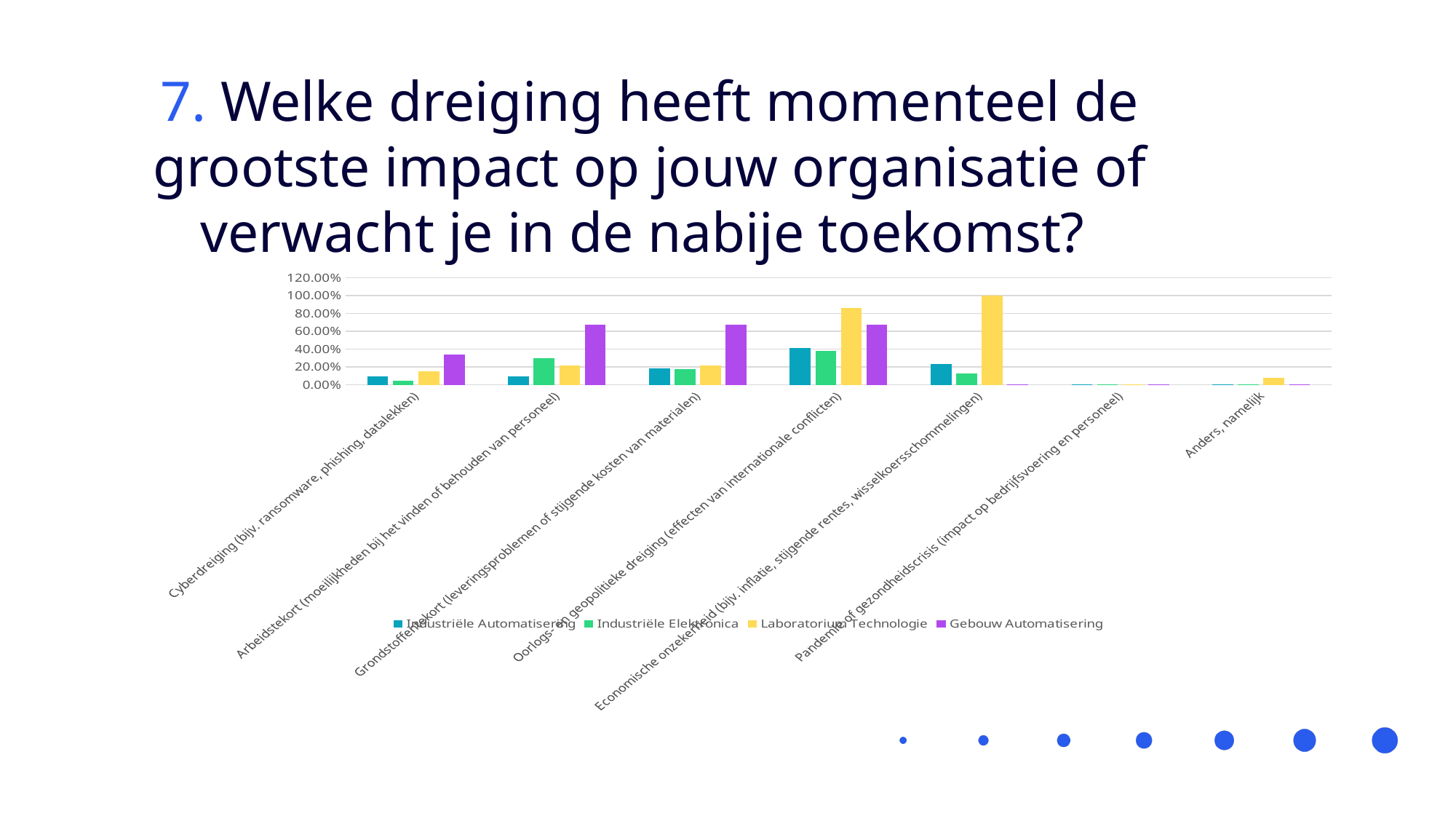
In the 'Arbeidstekort' category, which is larger: Gebouw Automatisering or Industriële Automatisering? Gebouw Automatisering How many series does the legend list? 4 Is the value for Industriële Automatisering in the 'Cyberdreiging' category greater or less than 20.00%? less Which series has the lowest value in the 'Grondstoffentekort' category? Industriële Elektronica Is the value for Laboratorium Technologie in the 'Economische onzekerheid' category greater or less than 80.00%? greater Is the value for Gebouw Automatisering in the 'Arbeidstekort' category greater or less than 60.00%? greater What colour represents Laboratorium Technologie in the legend? yellow What kind of chart is shown on the slide? bar chart What is the value for Laboratorium Technologie in the 'Pandemie of gezondheidscrisis' category? 0.00% How many categories are shown along the x axis? 7